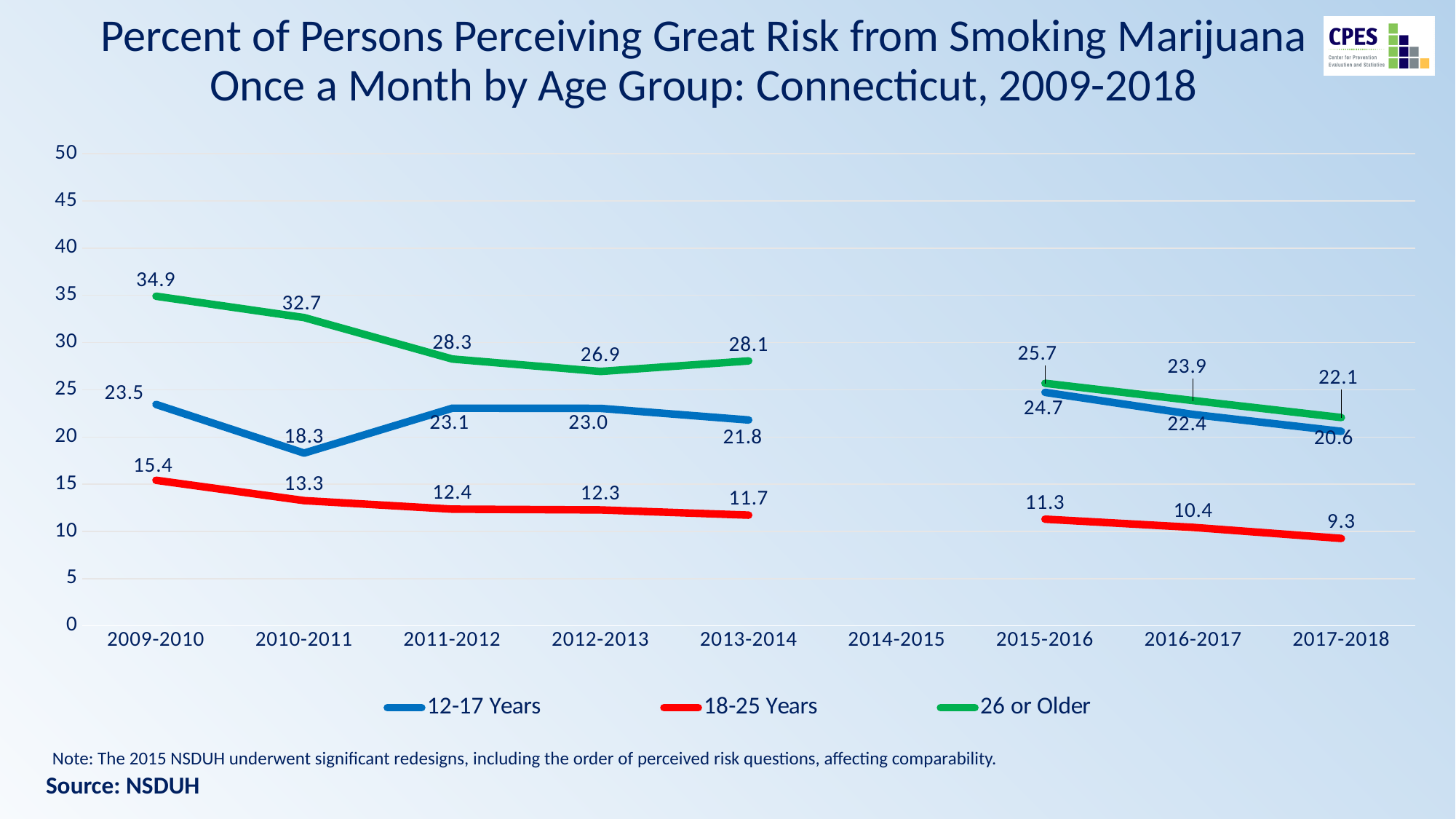
Does the 18-25 Years series rise or fall from 2009-2010 to 2013-2014? Fall Which colour represents the 26 or Older series? Green How many periods are labelled on the x axis? 9 Which is larger in 2012-2013: the 12-17 Years value or the 18-25 Years value? 12-17 Years What is the value for the 12-17 Years series in 2010-2011? 18.3 Which period has the highest value for the 26 or Older series? 2009-2010 What is the value for the 26 or Older series in 2009-2010? 34.9 How many series does the legend list? 3 Which period has the lowest value for the 18-25 Years series? 2017-2018 What is the value for the 18-25 Years series in 2017-2018? 9.3 What is the difference between the 26 or Older and 18-25 Years values in 2013-2014? 16.4 What kind of chart is shown on the slide? Line chart